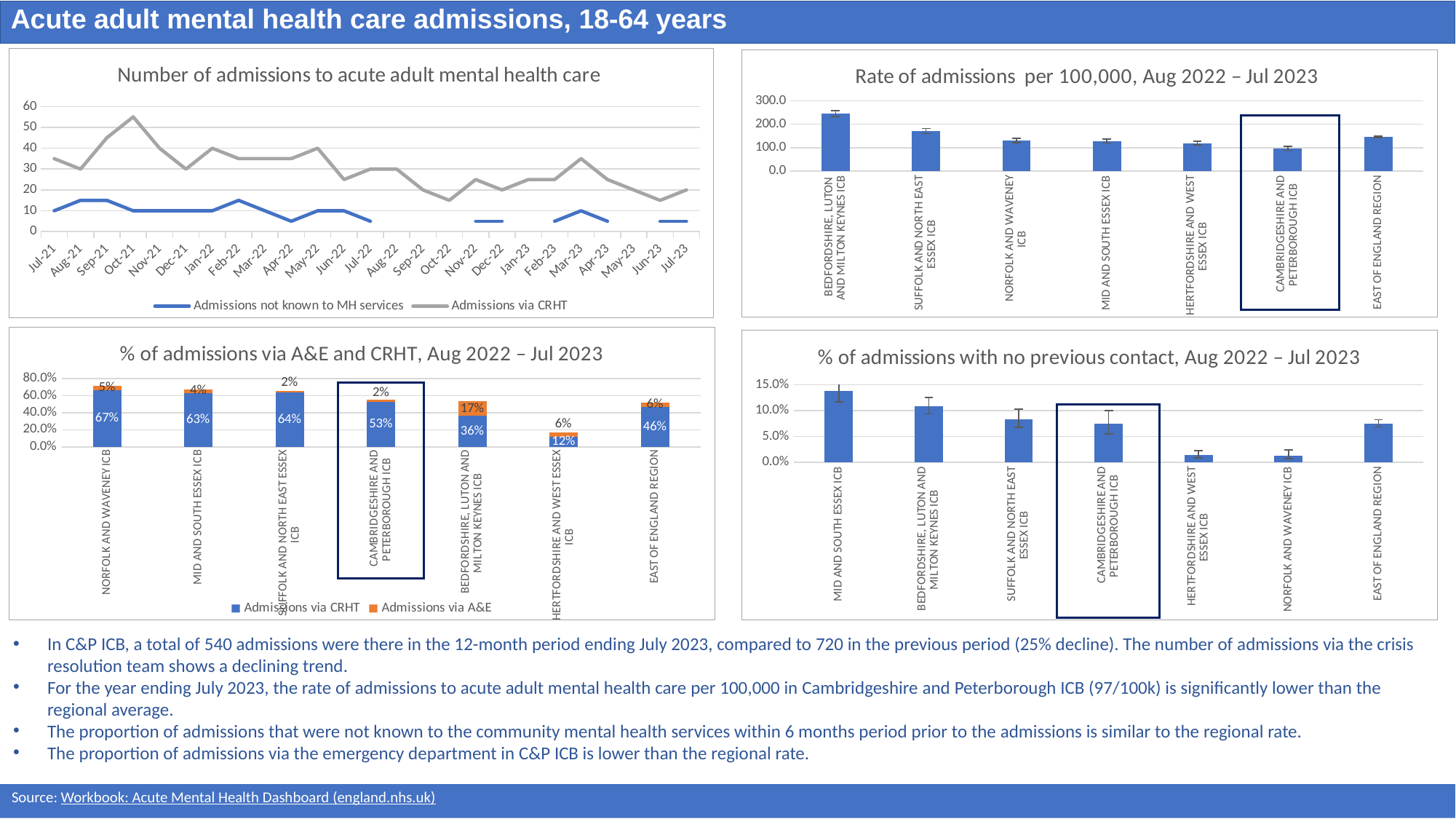
In the chart titled '% of admissions via A&E and CRHT, Aug 2022 – Jul 2023', which ICB has the highest percentage of admissions via A&E? Bedfordshire, Luton and Milton Keynes ICB In the chart titled '% of admissions via A&E and CRHT, Aug 2022 – Jul 2023', what percentage of admissions in Cambridgeshire and Peterborough ICB were via CRHT? 53% In the chart titled '% of admissions via A&E and CRHT, Aug 2022 – Jul 2023', how many percentage points higher is the CRHT share for Norfolk and Waveney ICB than for Cambridgeshire and Peterborough ICB? 14 percentage points In the chart titled 'Rate of admissions per 100,000, Aug 2022 – Jul 2023', is the value for Bedfordshire, Luton and Milton Keynes ICB greater or less than 200.0? greater In the chart titled '% of admissions via A&E and CRHT, Aug 2022 – Jul 2023', what percentage of admissions in Bedfordshire, Luton and Milton Keynes ICB were via A&E? 17% In the chart titled '% of admissions via A&E and CRHT, Aug 2022 – Jul 2023', which ICB has the lowest percentage of admissions via CRHT? Hertfordshire and West Essex ICB In the chart titled 'Rate of admissions per 100,000, Aug 2022 – Jul 2023', which ICB has the lowest rate? Cambridgeshire and Peterborough ICB What kind of chart is the chart titled 'Number of admissions to acute adult mental health care'? Line chart In the chart titled '% of admissions via A&E and CRHT, Aug 2022 – Jul 2023', what is the combined percentage of admissions via CRHT and A&E for Norfolk and Waveney ICB? 72% In the chart titled 'Rate of admissions per 100,000, Aug 2022 – Jul 2023', which ICB has the highest rate? Bedfordshire, Luton and Milton Keynes ICB How many series does the legend list in the chart titled 'Number of admissions to acute adult mental health care'? 2 In the chart titled '% of admissions with no previous contact, Aug 2022 – Jul 2023', which ICB has the highest value? Mid and South Essex ICB